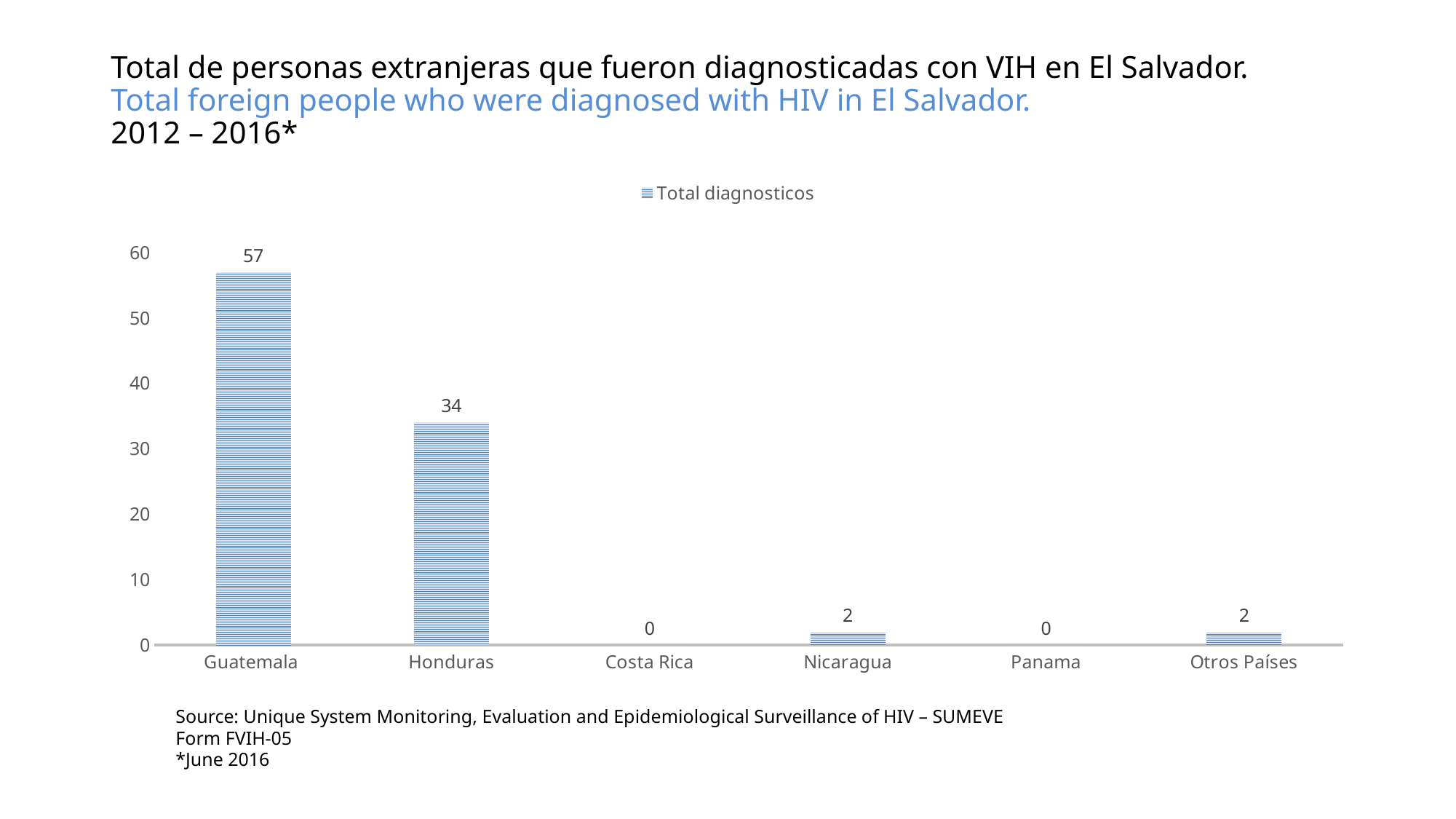
How many series does the legend list? 1 How many categories are shown on the x axis? 6 What is the difference between the values for Guatemala and Honduras? 23 Is the value for Guatemala greater or less than 50? greater Which country has the highest number of diagnoses? Guatemala What is the value for Nicaragua? 2 Which is larger, the value for Honduras or the value for Nicaragua? Honduras What is the value for Costa Rica? 0 What kind of chart is shown on the slide? bar chart What is the value for Guatemala? 57 What is the legend entry for the series? Total diagnosticos What is the value for Honduras? 34